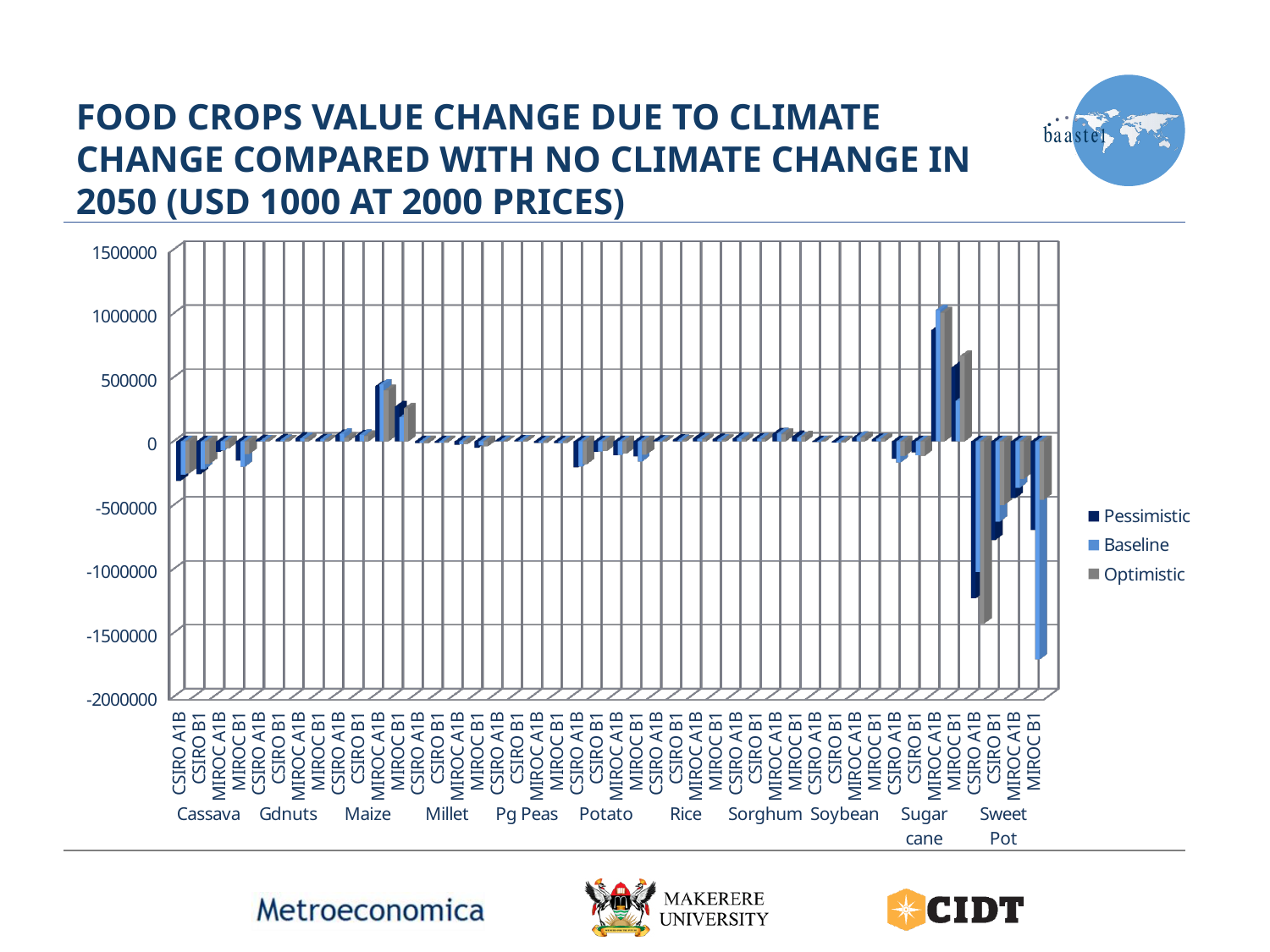
What kind of chart is shown on the slide? bar chart Is the Pessimistic value for Sugar cane MIROC A1B greater or less than 500000? greater Which crop and scenario has the lowest (most negative) bar on the chart? Sweet Pot, MIROC B1 How many series does the legend list? 3 Which is larger, the Baseline value for Sugar cane MIROC A1B or the Baseline value for Maize MIROC A1B? Sugar cane MIROC A1B Which is lower, the Baseline value for Sweet Pot MIROC B1 or the Baseline value for Sweet Pot CSIRO A1B? Sweet Pot MIROC B1 What are the three series named in the legend? Pessimistic, Baseline, Optimistic Is the Baseline value for Sweet Pot MIROC B1 greater or less than -1500000? less How many climate model scenarios (e.g. CSIRO A1B) are shown for each crop? 4 How many crops are shown along the x axis? 11 Is the Optimistic value for Sweet Pot CSIRO A1B greater or less than -1000000? less Which crop and scenario has the highest (most positive) bar on the chart? Sugar cane, MIROC A1B